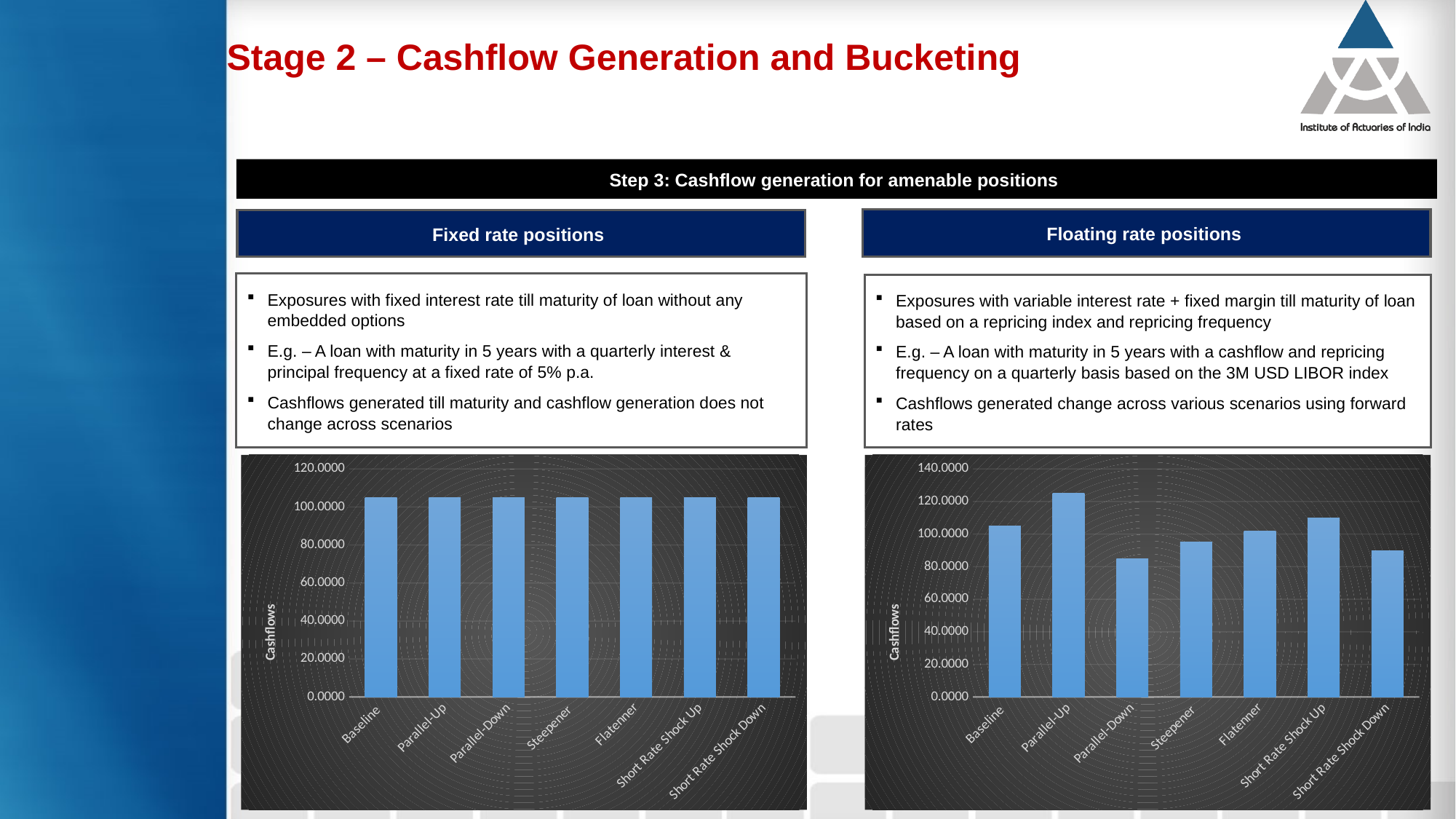
On the Fixed rate positions chart, do the bar values change across the scenarios along the x axis? No, they stay flat What is the y-axis label on the Floating rate positions chart? Cashflows On the Floating rate positions chart, which category has the lowest cashflow? Parallel-Down On the Floating rate positions chart, which is larger: Short Rate Shock Up or Short Rate Shock Down? Short Rate Shock Up On the Floating rate positions chart, which category has the highest cashflow? Parallel-Up What kind of chart is shown under the Fixed rate positions heading? bar chart On the Floating rate positions chart, which is larger: Steepener or Parallel-Up? Parallel-Up On the Fixed rate positions chart, is the value for Baseline greater or less than 100.0000? greater On the Floating rate positions chart, is the value for Parallel-Up greater or less than 120.0000? greater How many categories are plotted on the Floating rate positions chart? 7 On the Floating rate positions chart, is the value for Parallel-Down greater or less than 100.0000? less What is the highest tick value shown on the y axis of the Floating rate positions chart? 140.0000